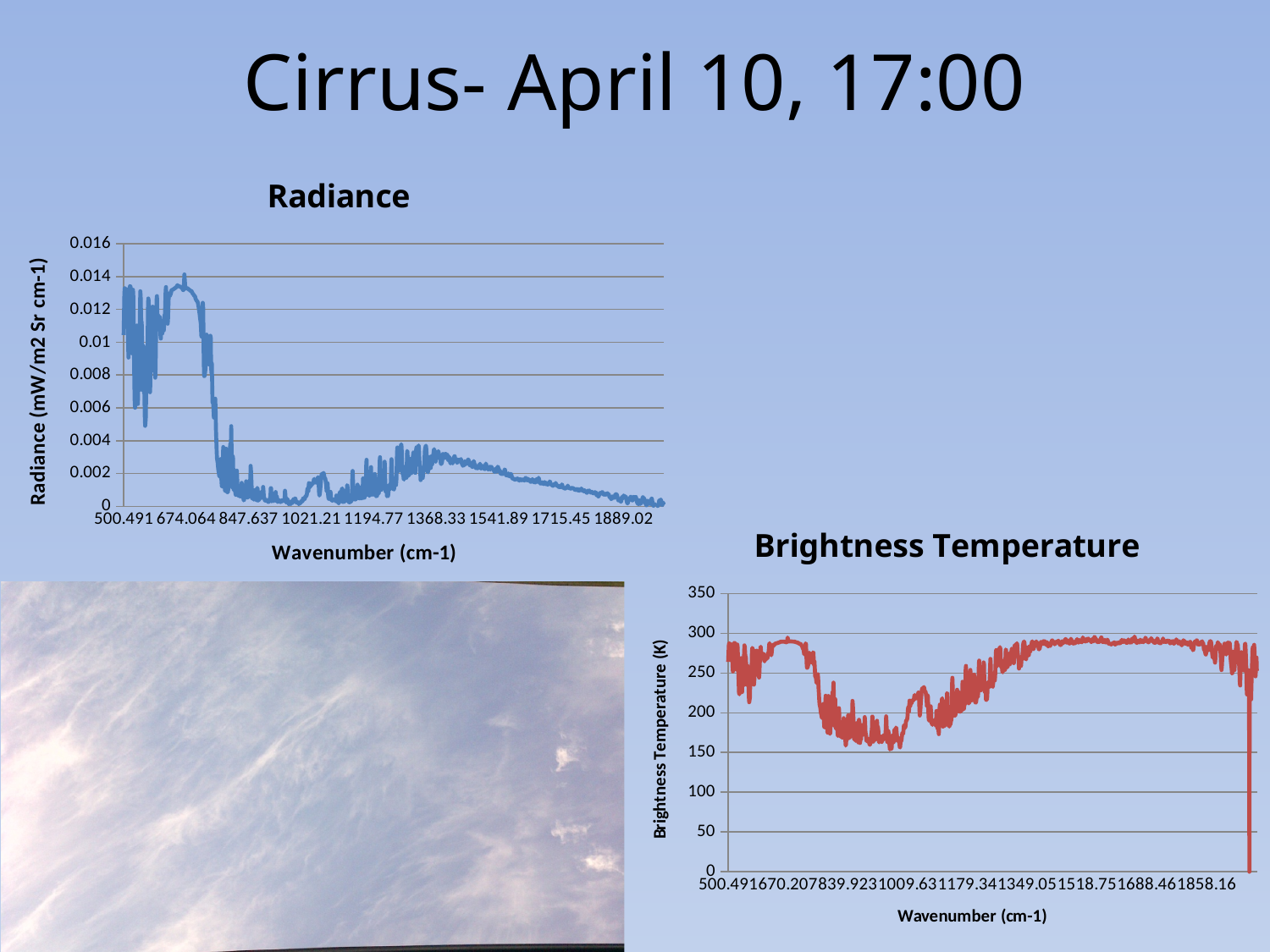
What kind of chart is the Brightness Temperature chart? line chart On the Radiance chart, does the radiance rise or fall between wavenumbers 1368.33 and 1889.02? fall On the Radiance chart, is the peak radiance near wavenumber 674.064 greater or less than 0.01? greater On the Brightness Temperature chart, is the brightness temperature at wavenumber 1518.75 greater or less than 250? greater On the Radiance chart, what is the label of the y axis? Radiance (mW/m2 Sr cm-1) How many charts are shown on the slide? 2 On the Brightness Temperature chart, what is the label of the x axis? Wavenumber (cm-1) On the Brightness Temperature chart, what is the highest value shown on the y axis? 350 What kind of chart is the Radiance chart? line chart On the Brightness Temperature chart, does the brightness temperature rise or fall between wavenumbers 839.923 and 1009.63? fall On the Radiance chart, is the radiance at wavenumber 1021.21 greater or less than 0.004? less